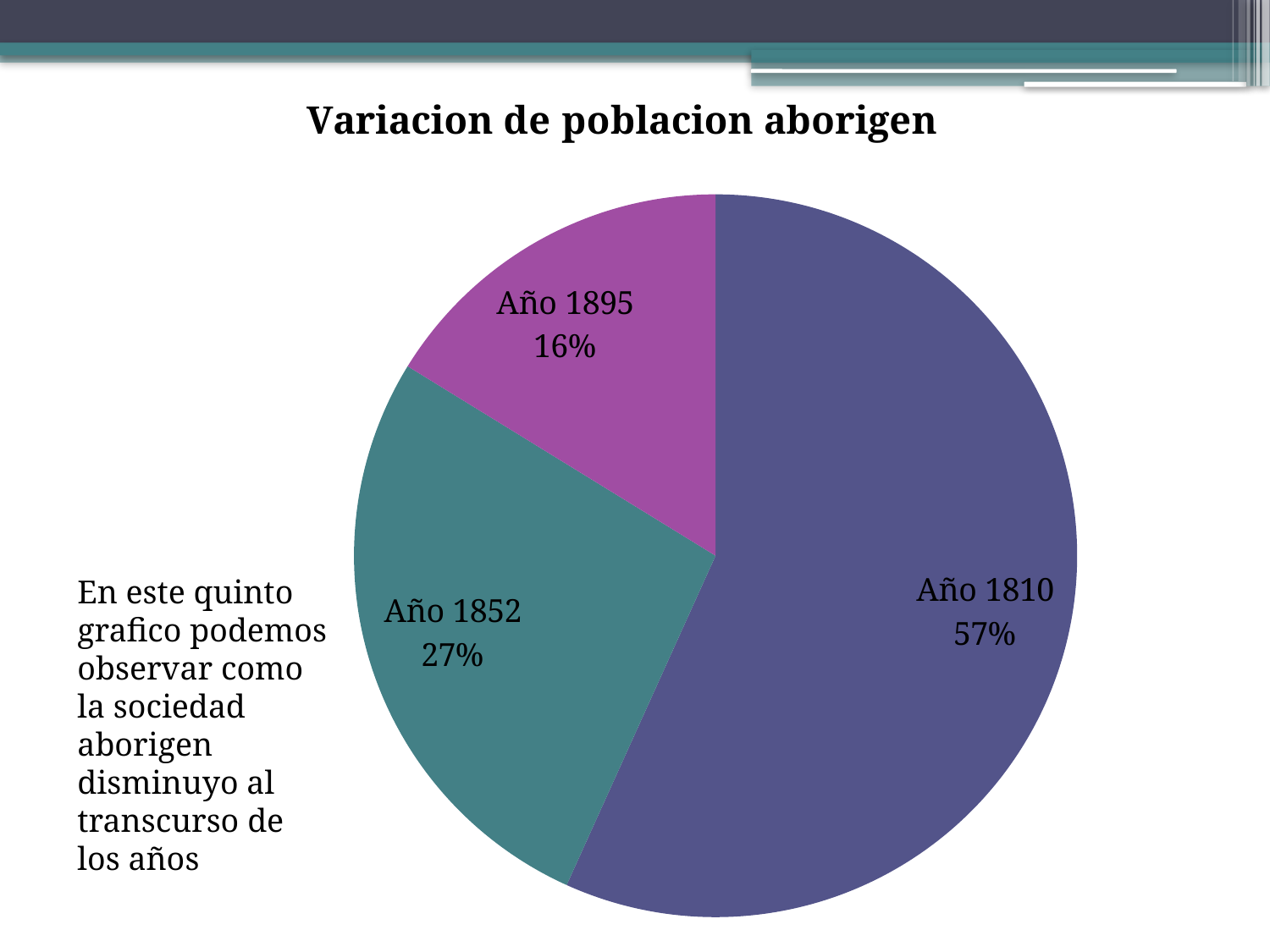
Which is larger, the share for Año 1852 or the share for Año 1895? Año 1852 What share of the pie does Año 1852 represent? 27% What share of the pie does Año 1895 represent? 16% What is the difference in percentage points between Año 1852 and Año 1895? 11 What share of the pie does Año 1810 represent? 57% What is the title of the chart? Variacion de poblacion aborigen How many slices does the pie chart have? 3 What is the difference in percentage points between Año 1810 and Año 1852? 30 What kind of chart is shown on the slide? Pie chart What colour is the slice for Año 1895? Purple/magenta Which slice is the smallest? Año 1895 Which slice is the largest? Año 1810